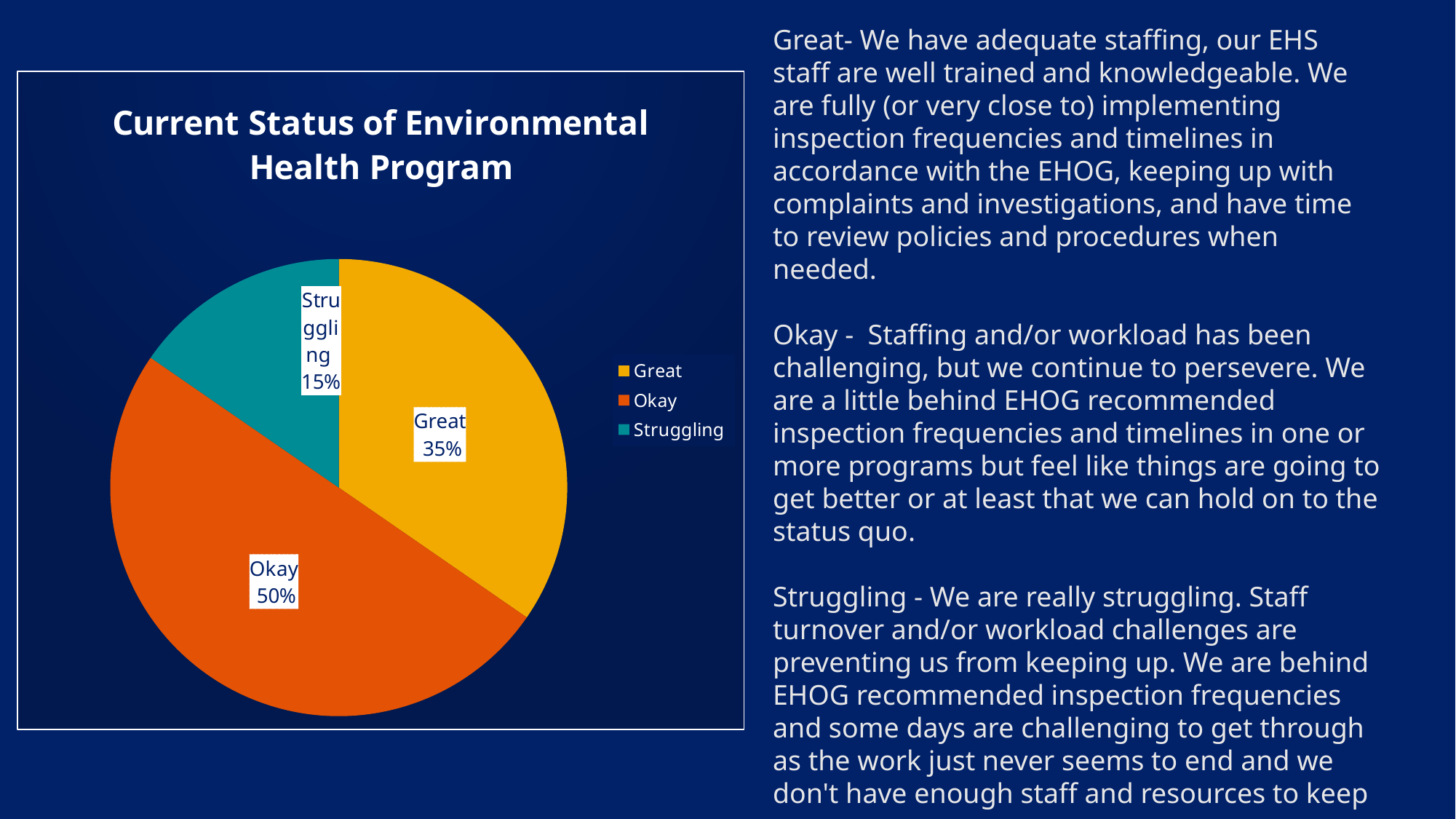
Which category has the smallest share of the pie? Struggling What kind of chart is shown on the slide? pie chart What percentage of the pie is labelled Okay? 50% What is the difference in percentage points between the Okay and Great slices? 15 Which category has the largest share of the pie? Okay What is the title of the chart? Current Status of Environmental Health Program What percentage of the pie is labelled Great? 35% What percentage of the pie is labelled Struggling? 15% What colour is the Okay slice? orange How many entries does the legend list? 3 How many slices does the pie chart have? 3 Which is larger, the Great slice or the Struggling slice? Great